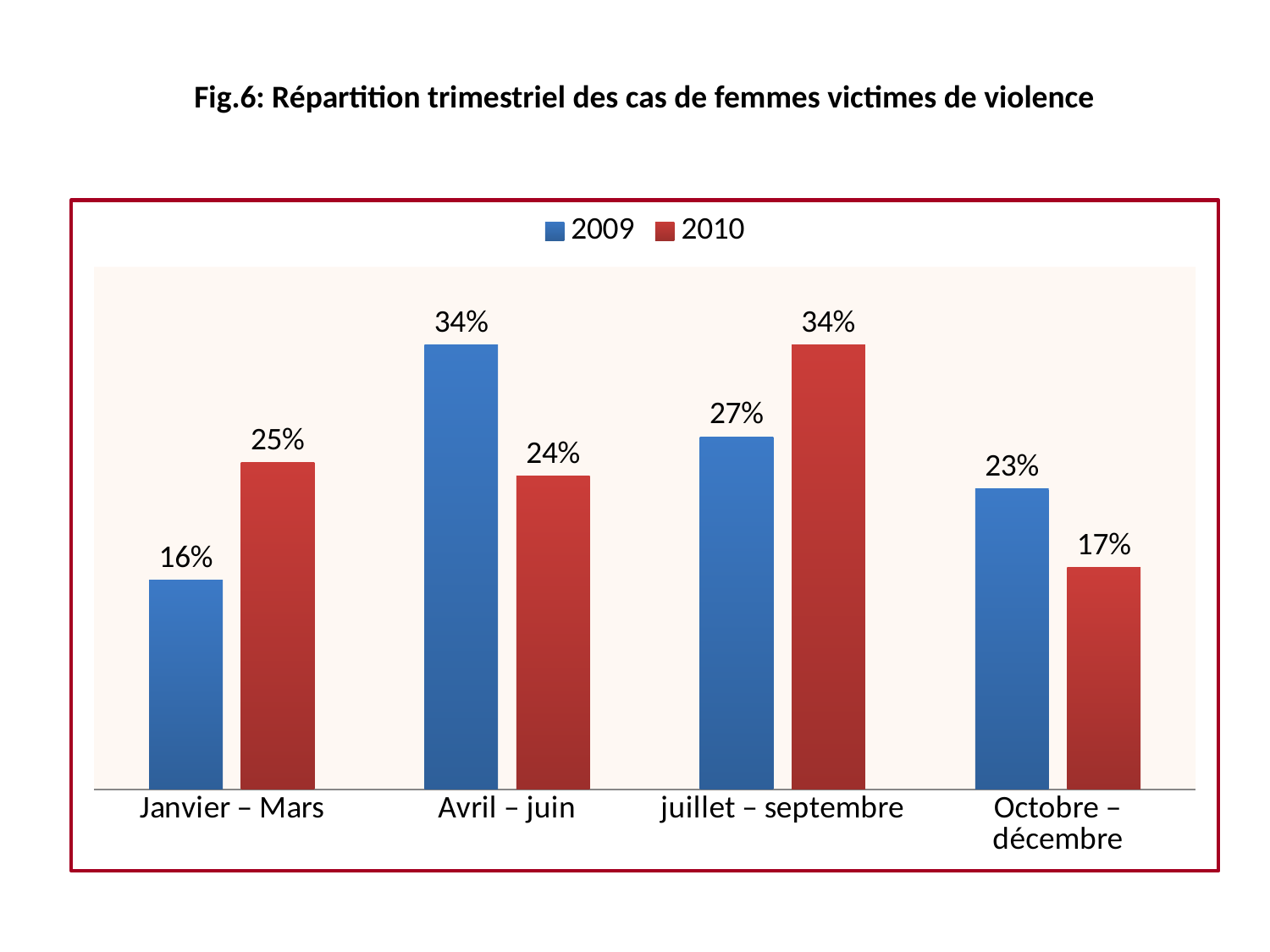
How many quarters are shown on the x axis? 4 How many series does the legend list? 2 Which is larger in Janvier – Mars, the 2009 value or the 2010 value? 2010 What is the value for 2009 in Janvier – Mars? 16% What is the value for 2010 in Avril – juin? 24% What is the value for 2010 in Octobre – décembre? 17% What is the difference between the 2010 and 2009 values in juillet – septembre? 7% Which quarter has the highest value for 2009? Avril – juin Which quarter has the lowest value for 2010? Octobre – décembre What kind of chart is shown on the slide? Bar chart Which colour represents the 2010 series? Red What is the title of the chart? Fig.6: Répartition trimestriel des cas de femmes victimes de violence